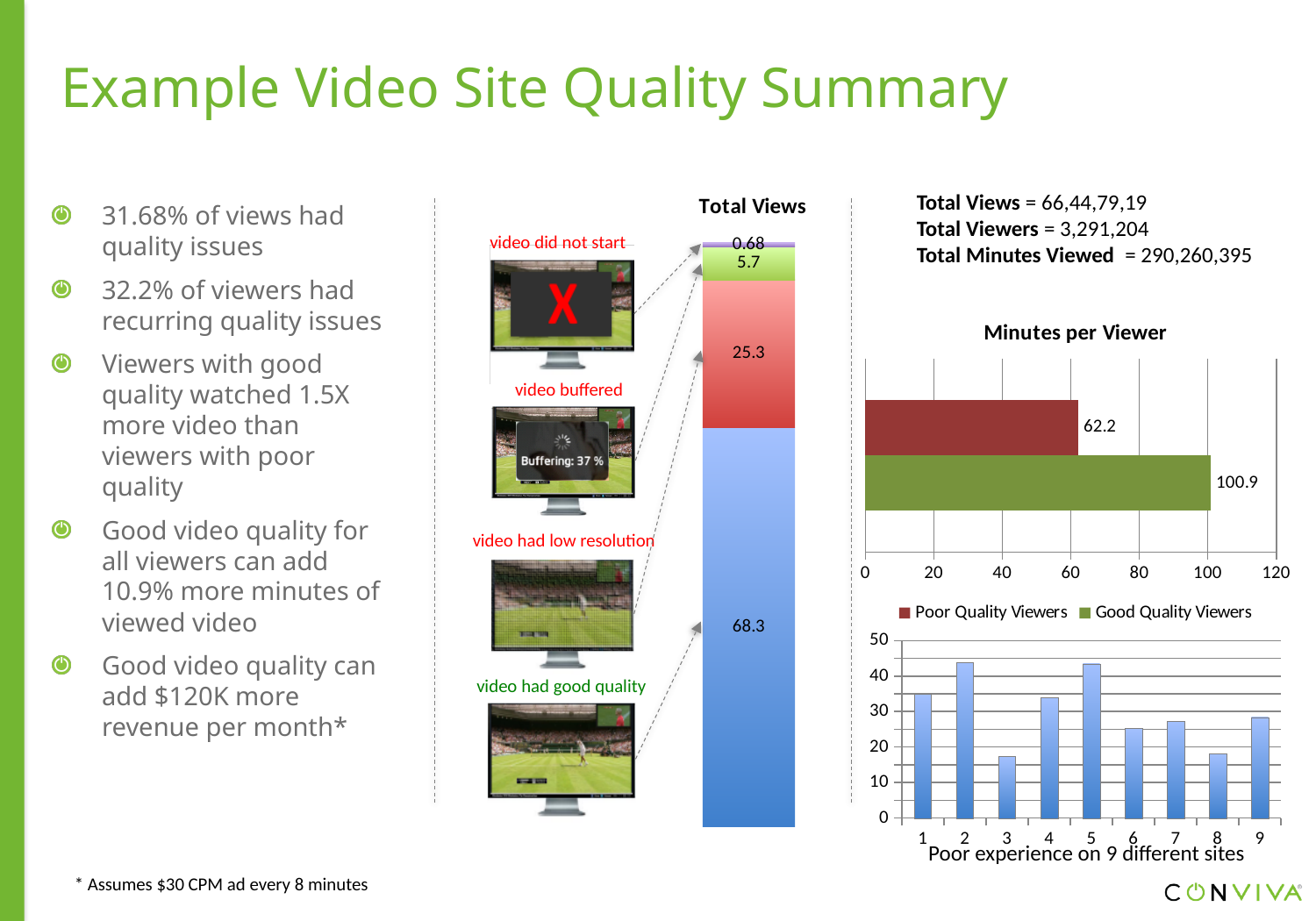
In the 'Poor experience on 9 different sites' chart, how many bars are plotted? 9 In the Total Views stacked bar, which segment is the smallest? video did not start In the Minutes per Viewer chart, what is the difference between Good Quality Viewers and Poor Quality Viewers? 38.7 In the Minutes per Viewer chart, what is the value for Poor Quality Viewers? 62.2 What kind of chart is the Minutes per Viewer chart? Bar chart In the Minutes per Viewer chart, how many series does the legend list? 2 In the Total Views stacked bar, what is the value for the segment labelled 'video had low resolution'? 25.3 In the Minutes per Viewer chart, what is the value for Good Quality Viewers? 100.9 In the Total Views stacked bar, what is the value for the segment labelled 'video had good quality'? 68.3 In the Total Views stacked bar, which is larger: the 'video buffered' segment or the 'video did not start' segment? video buffered In the 'Poor experience on 9 different sites' chart, is the value for site 2 greater or less than 40? greater In the 'Poor experience on 9 different sites' chart, is the value for site 3 greater or less than 20? less